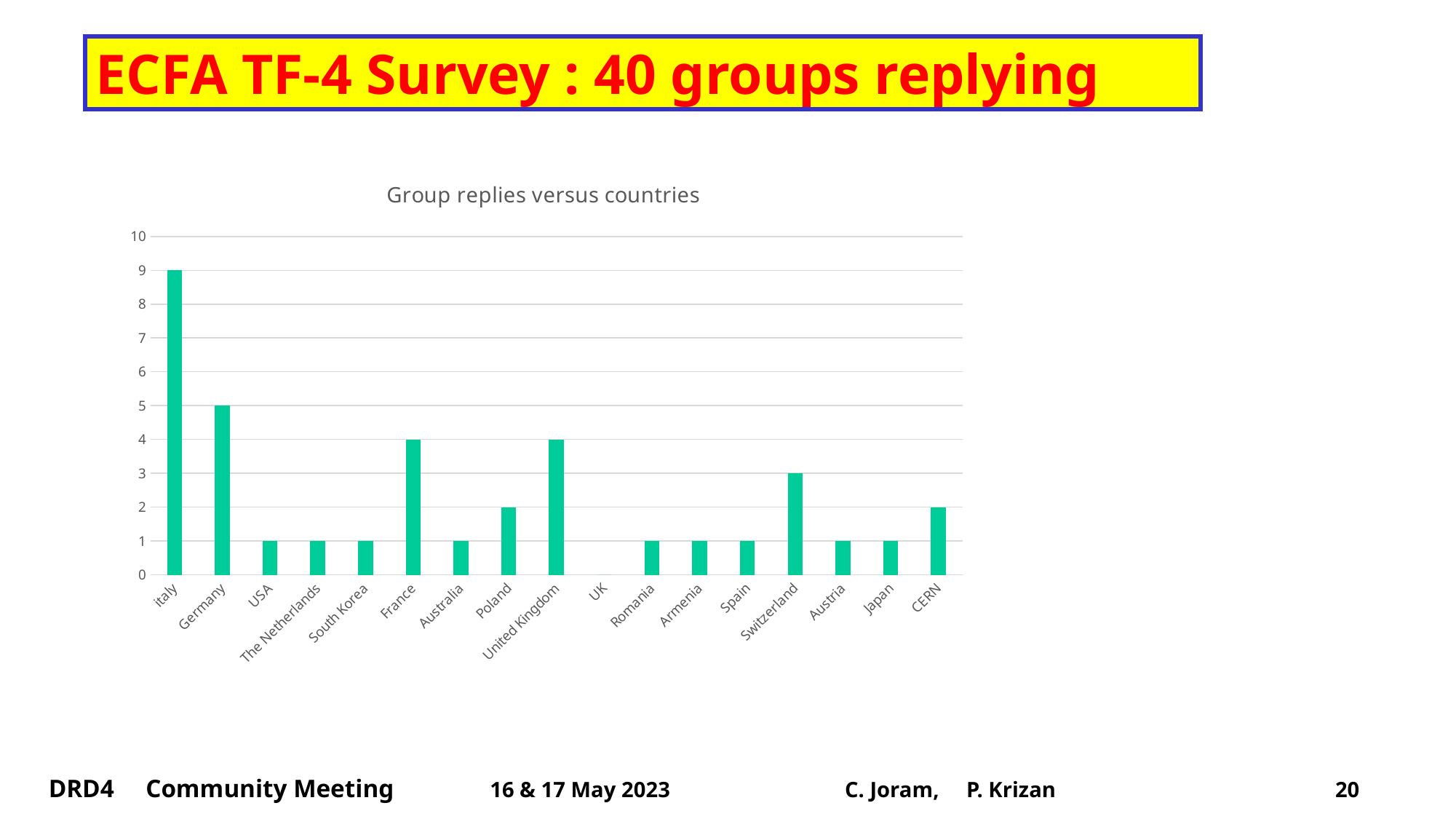
How many group replies are shown for Germany? 5 Is the value for Italy greater or less than 8? greater How many group replies are shown for Switzerland? 3 What is the difference in group replies between Italy and Germany? 4 What is the title of the chart? Group replies versus countries How many group replies are shown for CERN? 2 What type of chart is shown on the slide? bar chart Which has more group replies, Poland or Switzerland? Switzerland How many group replies are shown for Italy? 9 How many group replies are shown for France? 4 How many country categories are listed on the x axis? 17 Which country has the highest number of group replies? Italy